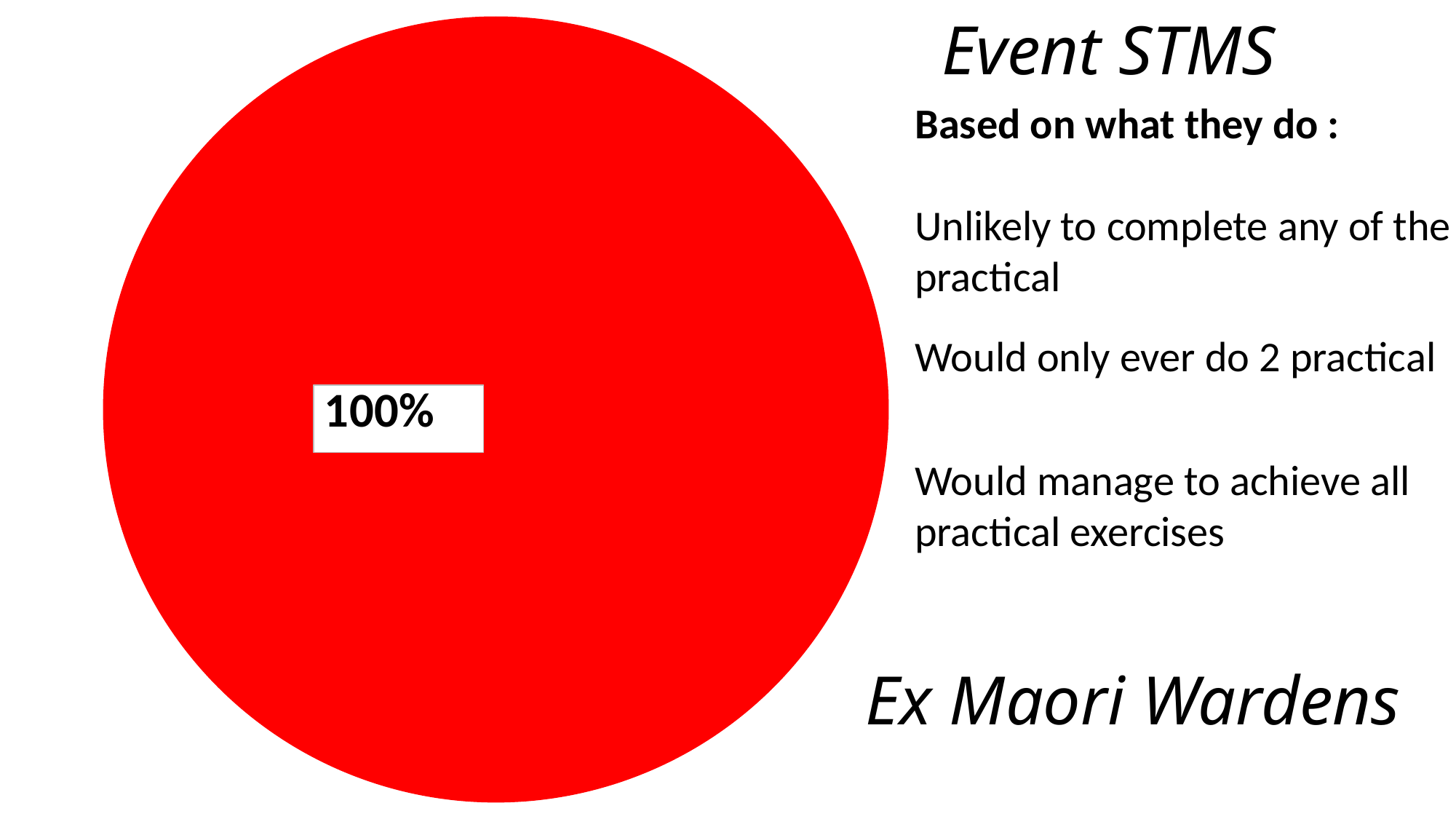
What percentage is printed on the pie chart's slice? 100% What share of the pie does the single slice take up? 100% How many slices does the pie chart have? 1 Does the pie chart show a legend? no What kind of chart is shown on the slide? pie chart What colour is the slice of the pie chart? red